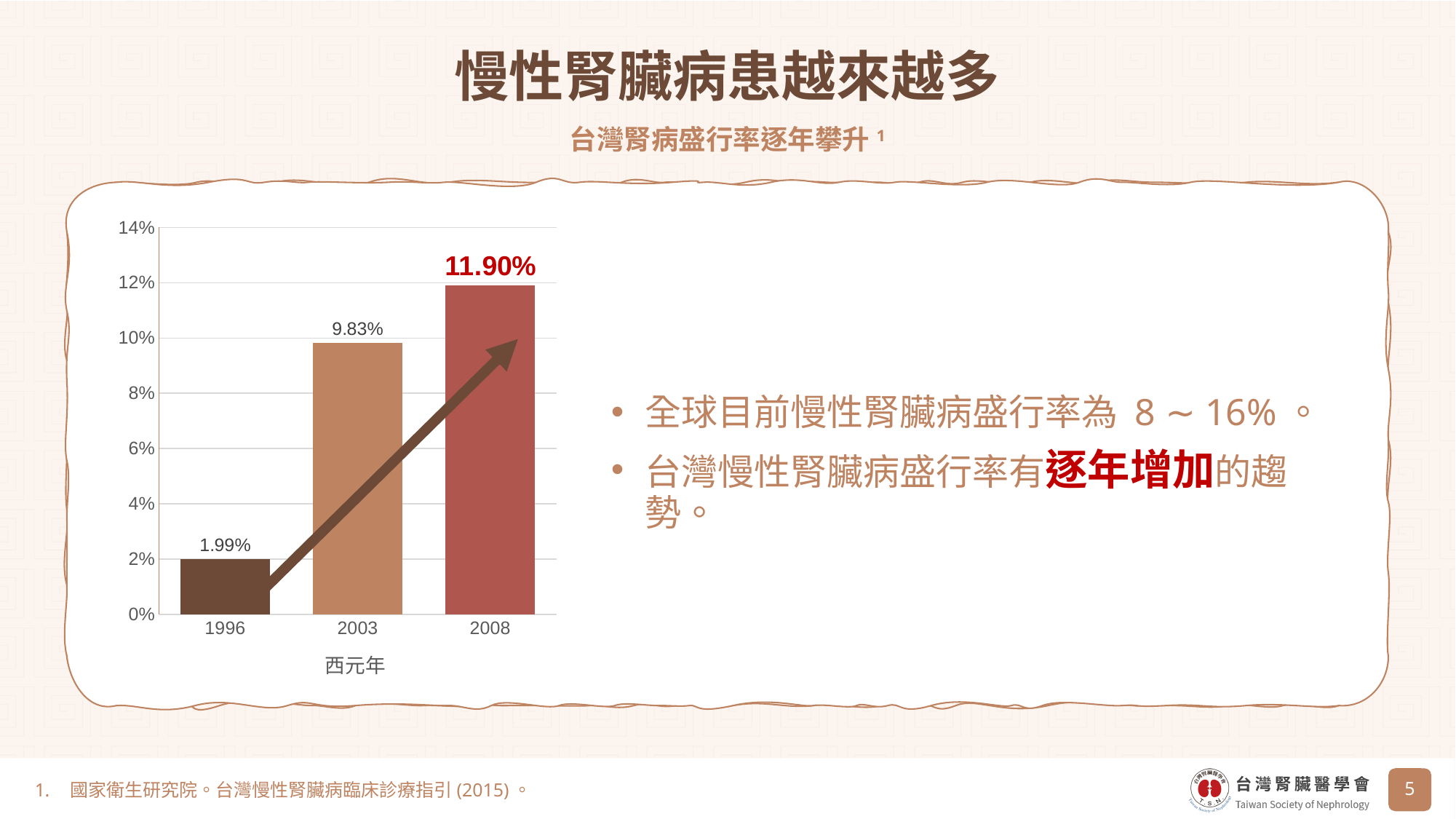
Which year has the lowest value? 1996 What is the value for 2003? 9.83% What is the value for 2008? 11.90% Do the values rise or fall from 1996 to 2008? rise Which is larger, the value for 2003 or the value for 1996? 2003 What is the difference between the values for 2008 and 2003? 2.07% What is the difference between the values for 2003 and 1996? 7.84% What kind of chart is shown? bar chart How many years are shown on the x axis? 3 Which year has the highest value? 2008 What is the value for 1996? 1.99% Is the value for 2008 greater or less than 10%? greater